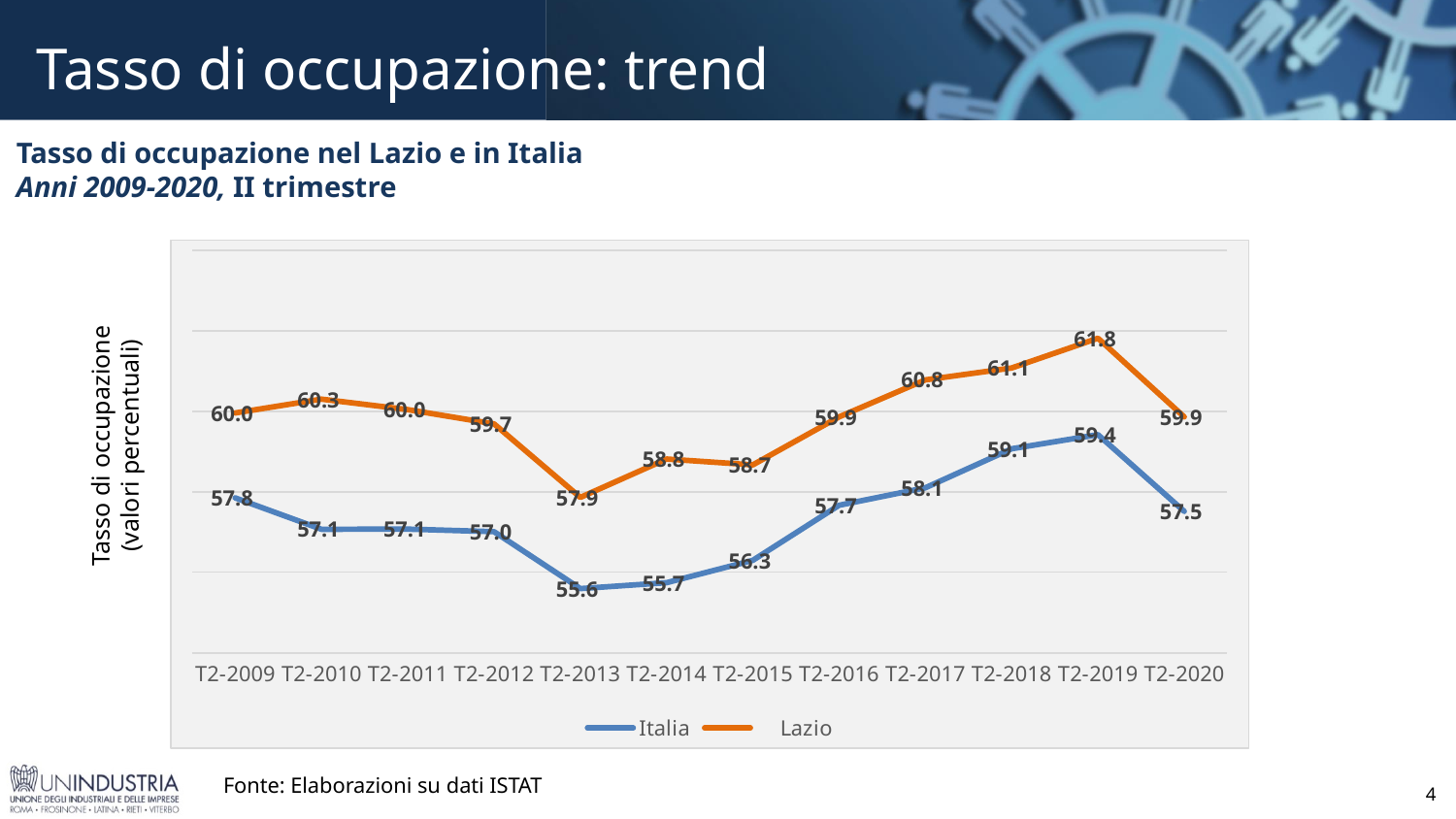
How many time points are plotted along the x axis? 12 How many series does the legend list? 2 Does the Italia series rise or fall from T2-2019 to T2-2020? fall What is the value for Italia in T2-2013? 55.6 In which period does the Lazio series reach its highest value? T2-2019 What type of chart is shown on the slide? line chart In which period does the Italia series reach its lowest value? T2-2013 What is the value for Italia in T2-2020? 57.5 What is the difference between Lazio and Italia in T2-2019? 2.4 Which is larger in T2-2016, the value for Lazio or the value for Italia? Lazio Which series is drawn in orange? Lazio What is the value for Lazio in T2-2019? 61.8